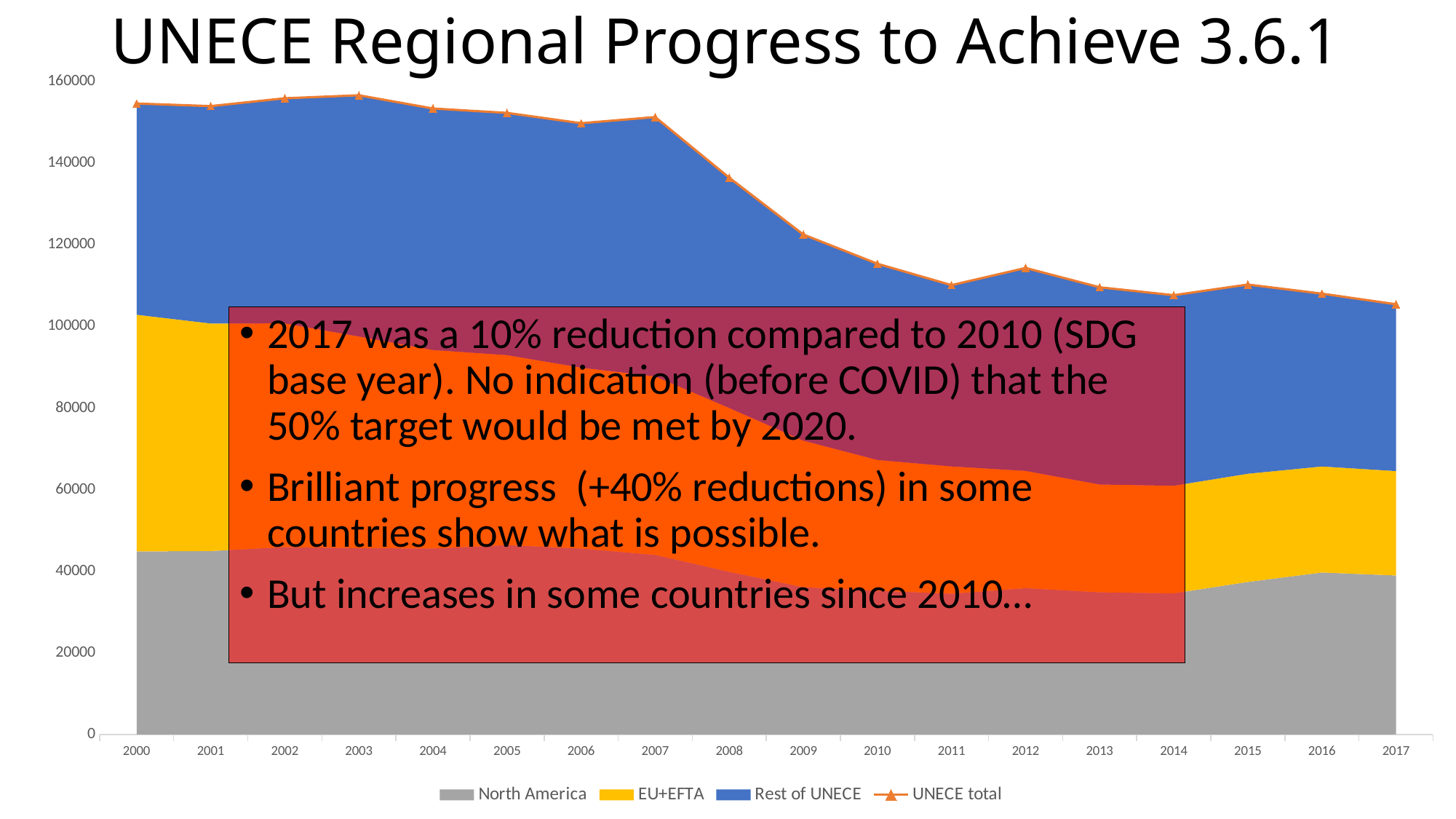
Is the UNECE total for 2000 greater or less than 140000? greater Which series is shown in grey at the bottom of the stack? North America Which is larger, the UNECE total in 2007 or in 2008? 2007 Is the UNECE total for 2008 greater or less than 140000? less How many years are shown along the x axis? 18 Which year has the lowest UNECE total? 2017 How many series does the legend list? 4 Does the UNECE total generally rise or fall from 2000 to 2017? fall What is the title of the chart? UNECE Regional Progress to Achieve 3.6.1 Is the UNECE total for 2017 greater or less than 120000? less What kind of chart is shown on the slide? Stacked area chart with a line for the total